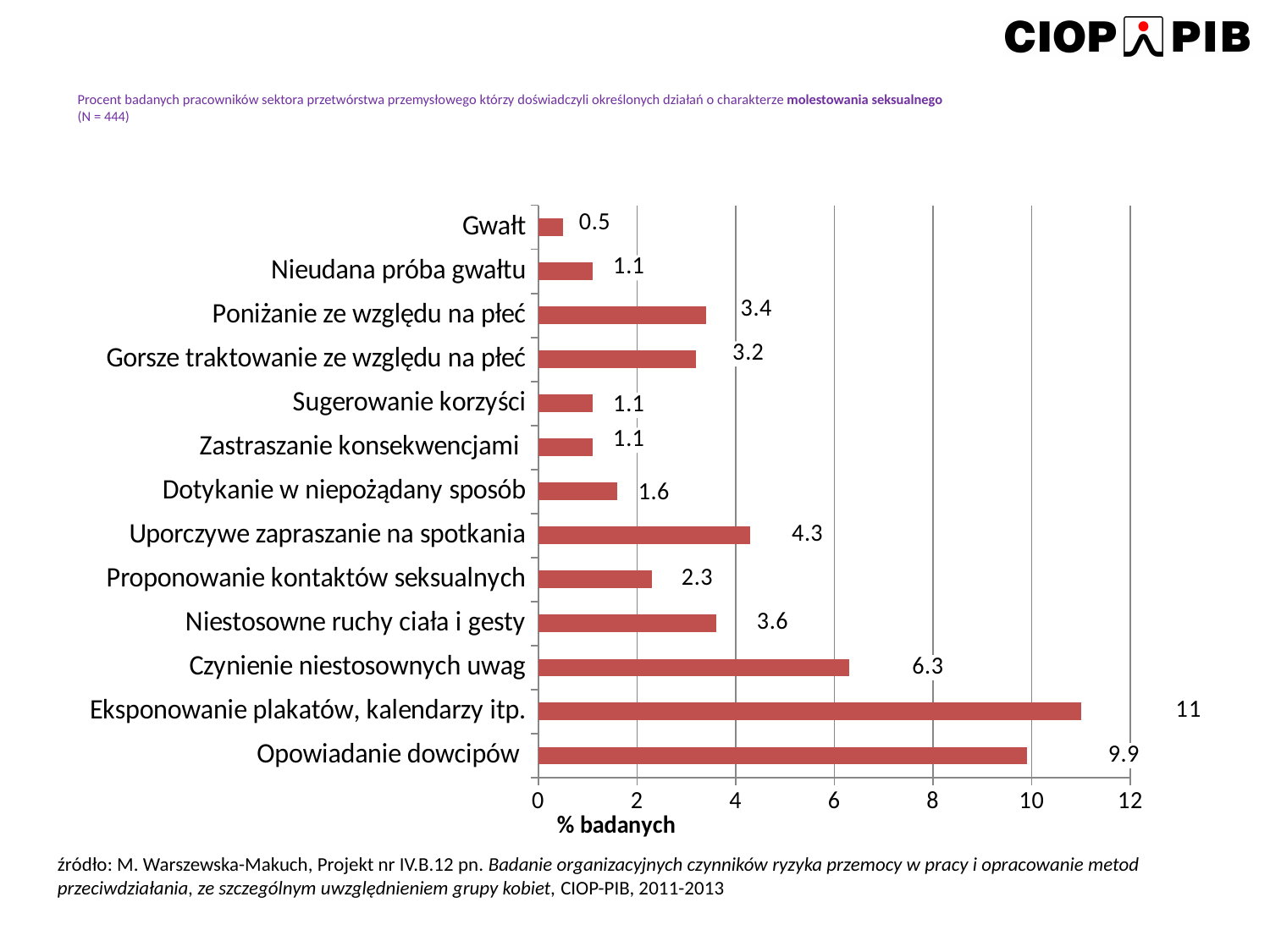
What kind of chart is shown on the slide? bar chart What is the value for "Eksponowanie plakatów, kalendarzy itp."? 11 How many categories are shown in the chart? 13 Which category has the highest value? Eksponowanie plakatów, kalendarzy itp. What is the value for "Czynienie niestosownych uwag"? 6.3 What is the difference between the values for "Poniżanie ze względu na płeć" and "Gorsze traktowanie ze względu na płeć"? 0.2 What is the difference between the values for "Eksponowanie plakatów, kalendarzy itp." and "Opowiadanie dowcipów"? 1.1 What is the label of the horizontal axis? % badanych Is the value for "Opowiadanie dowcipów" greater or less than 8? greater Which is larger: the value for "Uporczywe zapraszanie na spotkania" or "Niestosowne ruchy ciała i gesty"? Uporczywe zapraszanie na spotkania What is the value for "Gwałt"? 0.5 Which category has the lowest value? Gwałt